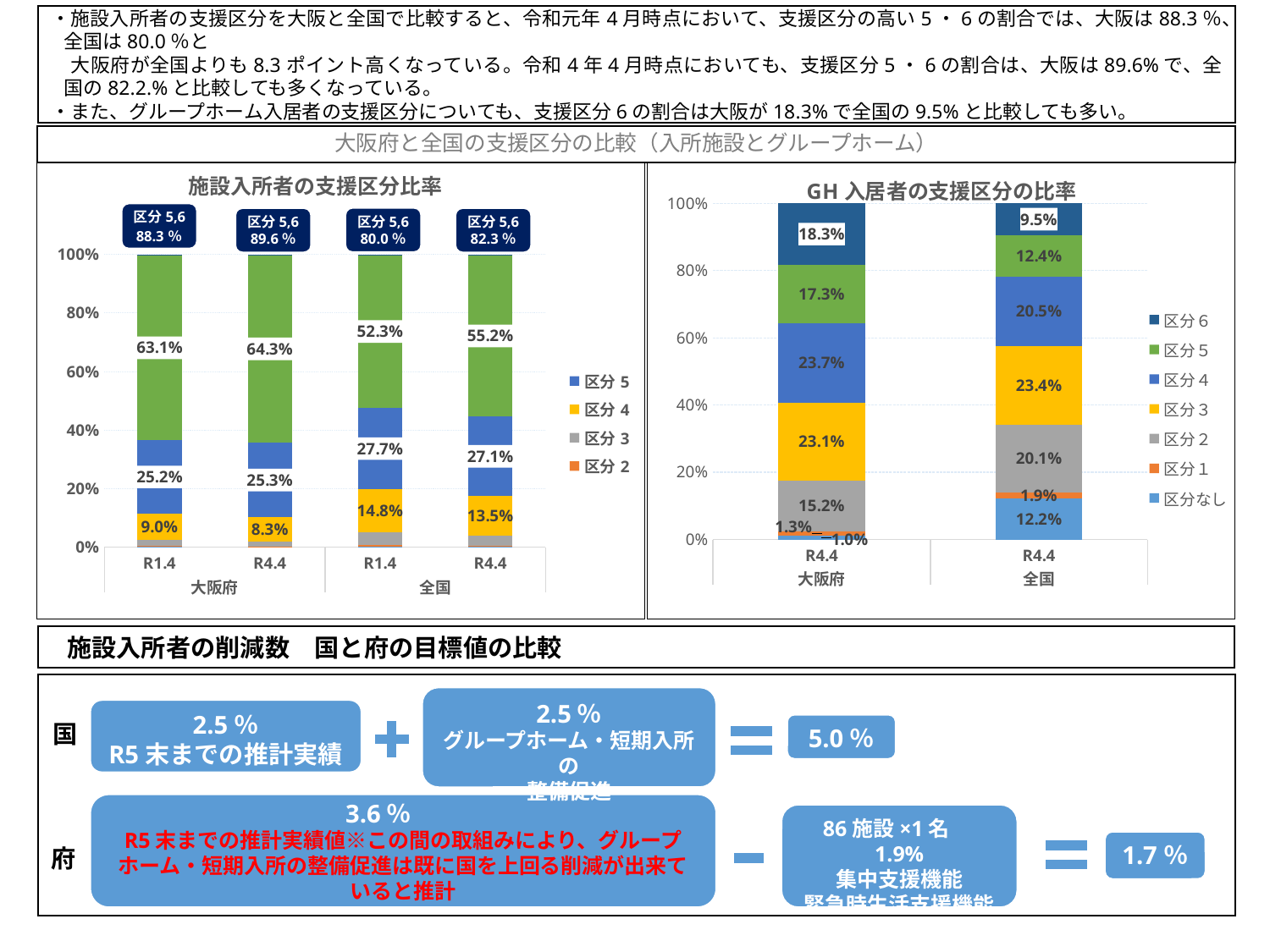
In the chart titled GH入居者の支援区分の比率, what is the 区分6 value for 大阪府 R4.4? 18.3% In the chart titled 施設入所者の支援区分比率, how many series does the legend list? 4 In the chart titled 施設入所者の支援区分比率, what is the 区分5 value for 大阪府 R4.4? 25.3% What kind of chart is the chart titled GH入居者の支援区分の比率? Stacked bar chart In the chart titled GH入居者の支援区分の比率, what is the difference between the 区分6 values for 大阪府 and 全国? 8.8 percentage points In the chart titled 施設入所者の支援区分比率, what is the difference between the 区分5 values for 大阪府 R1.4 and 全国 R1.4? 2.5 percentage points In the chart titled GH入居者の支援区分の比率, what is the 区分なし value for 全国 R4.4? 12.2% In the chart titled 施設入所者の支援区分比率, what 区分5,6 share is shown in the callout above the 大阪府 R1.4 bar? 88.3% In the chart titled GH入居者の支援区分の比率, how many series does the legend list? 7 In the chart titled 施設入所者の支援区分比率, which bar has the highest 区分5 value? 全国 R1.4 In the chart titled GH入居者の支援区分の比率, which is larger, the 区分4 value for 大阪府 or for 全国? 大阪府